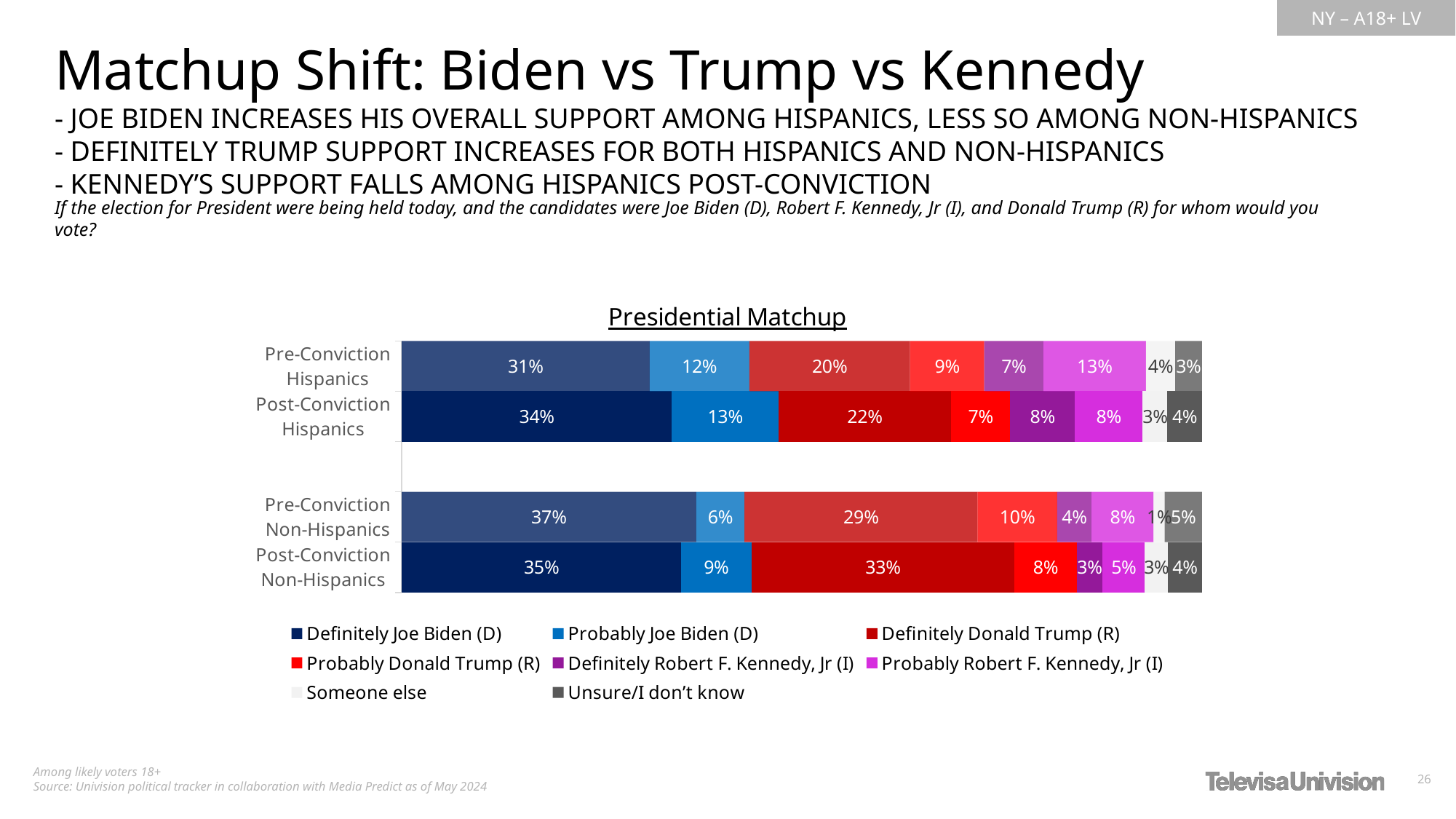
What is the Definitely Donald Trump (R) value for Post-Conviction Non-Hispanics? 33% What is the Someone else value for Pre-Conviction Non-Hispanics? 1% What is the Probably Robert F. Kennedy, Jr (I) value for Pre-Conviction Hispanics? 13% What is the difference between the Definitely Donald Trump (R) values for Post-Conviction Non-Hispanics and Pre-Conviction Non-Hispanics? 4% Which category has the highest Definitely Joe Biden (D) value? Pre-Conviction Non-Hispanics What is the Definitely Joe Biden (D) value for Post-Conviction Hispanics? 34% How many category bars are shown in the Presidential Matchup chart? 4 How many series does the legend of the Presidential Matchup chart list? 8 Which is larger: the Probably Joe Biden (D) value for Post-Conviction Hispanics or for Post-Conviction Non-Hispanics? Post-Conviction Hispanics What kind of chart is the Presidential Matchup chart? Stacked bar chart What is the total of the stacked bar for Pre-Conviction Non-Hispanics? 100% Which category has the lowest Definitely Donald Trump (R) value? Pre-Conviction Hispanics